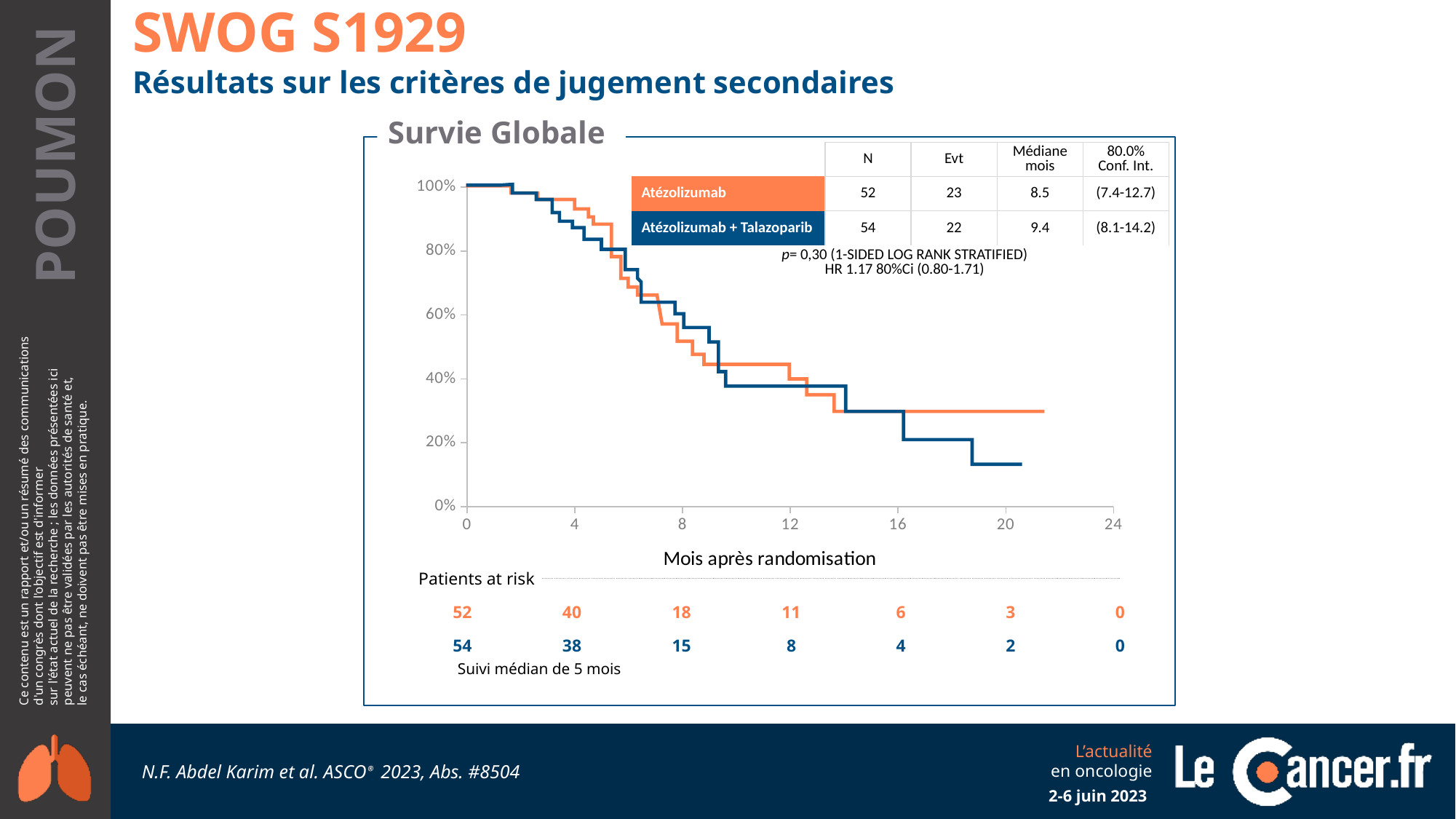
Do the survival curves rise or fall as months after randomisation increase? Fall How many series (treatment arms) are plotted on the Survie Globale chart? 2 What is the median overall survival in months for the Atézolizumab arm? 8.5 Which arm has the higher median overall survival, Atézolizumab or Atézolizumab + Talazoparib? Atézolizumab + Talazoparib What is the title of the chart on the slide? Survie Globale What kind of chart is shown on the slide? Line chart (Kaplan-Meier survival curve) What is the median overall survival in months for the Atézolizumab + Talazoparib arm? 9.4 How many patients were at risk in the Atézolizumab arm at 8 months? 18 What is the 80.0% confidence interval for the median survival in the Atézolizumab + Talazoparib arm? (8.1-14.2) How many patients (N) are in the Atézolizumab + Talazoparib arm? 54 At 20 months, is the survival value for the Atézolizumab + Talazoparib curve greater or less than 20%? less How many events (Evt) were recorded in the Atézolizumab arm? 23